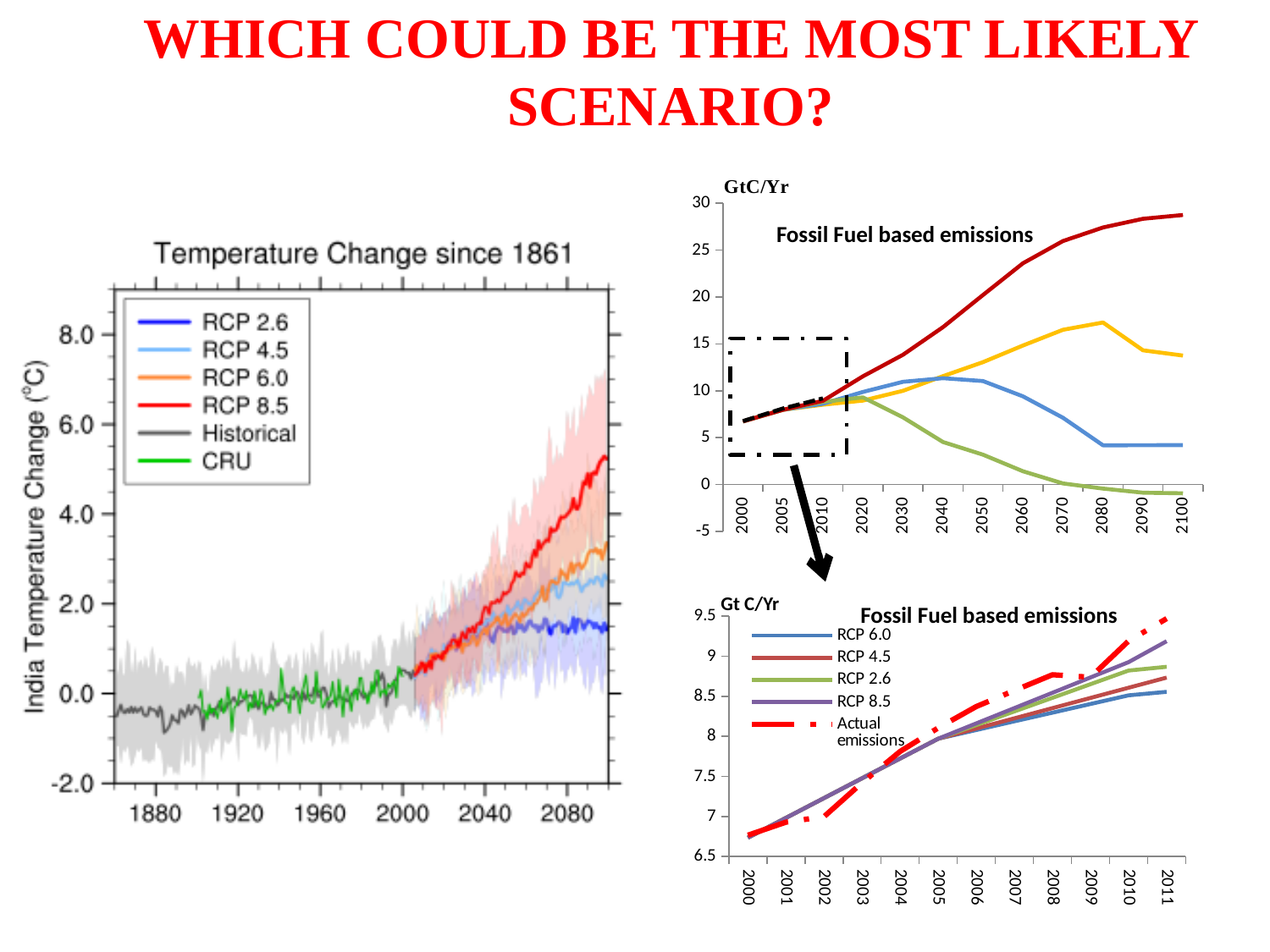
In the 'Temperature Change since 1861' chart, which RCP series is lowest around 2080? RCP 2.6 What kind of chart is the 'Temperature Change since 1861' chart on the left of the slide? line chart In the bottom-right 'Fossil Fuel based emissions' chart (2000-2011), which series is lowest in 2011? RCP 6.0 In the bottom-right 'Fossil Fuel based emissions' chart (2000-2011), is the Actual emissions value in 2011 greater or less than 9? greater In the top-right 'Fossil Fuel based emissions' chart (2000-2100), is the value of the green line at 2100 greater or less than 0? less How many series does the legend of the 'Temperature Change since 1861' chart list? 6 In the 'Temperature Change since 1861' chart, which RCP series is highest around 2080? RCP 8.5 How many series does the legend of the bottom-right 'Fossil Fuel based emissions' chart (2000-2011) list? 5 In the 'Temperature Change since 1861' chart, is the RCP 8.5 value at the end of the series (around 2100) greater or less than 4.0? greater In the bottom-right 'Fossil Fuel based emissions' chart (2000-2011), which series is highest in 2011? Actual emissions In the top-right 'Fossil Fuel based emissions' chart (2000-2100), does the dark red line rise or fall from 2000 to 2100? rise